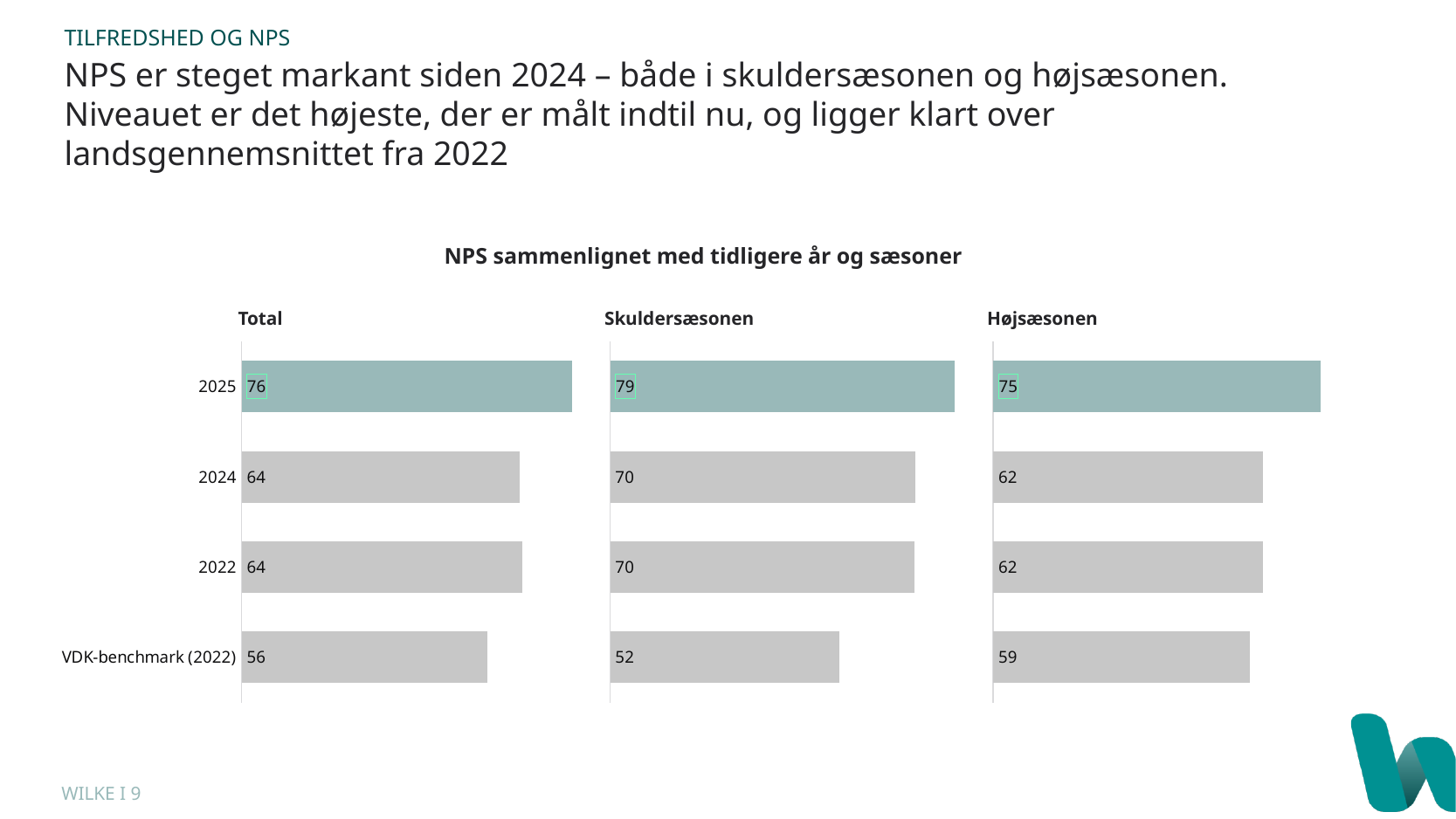
In the Skuldersæsonen chart, what is the value for VDK-benchmark (2022)? 52 In the Total chart, what is the NPS value for 2025? 76 In the Skuldersæsonen chart, which is larger: the value for 2025 or the value for 2022? 2025 What kind of chart is the Total chart? Bar chart In the Højsæsonen chart, what is the value for VDK-benchmark (2022)? 59 How many categories are shown in the Højsæsonen chart? 4 In the Skuldersæsonen chart, which category has the highest value? 2025 In the Total chart, what is the difference between the 2025 value and the VDK-benchmark (2022) value? 20 What is the overall title above the three charts? NPS sammenlignet med tidligere år og sæsoner In the Skuldersæsonen chart, what is the value for 2024? 70 In the Total chart, which category has the lowest value? VDK-benchmark (2022) In the Højsæsonen chart, what is the difference between the 2025 value and the 2024 value? 13